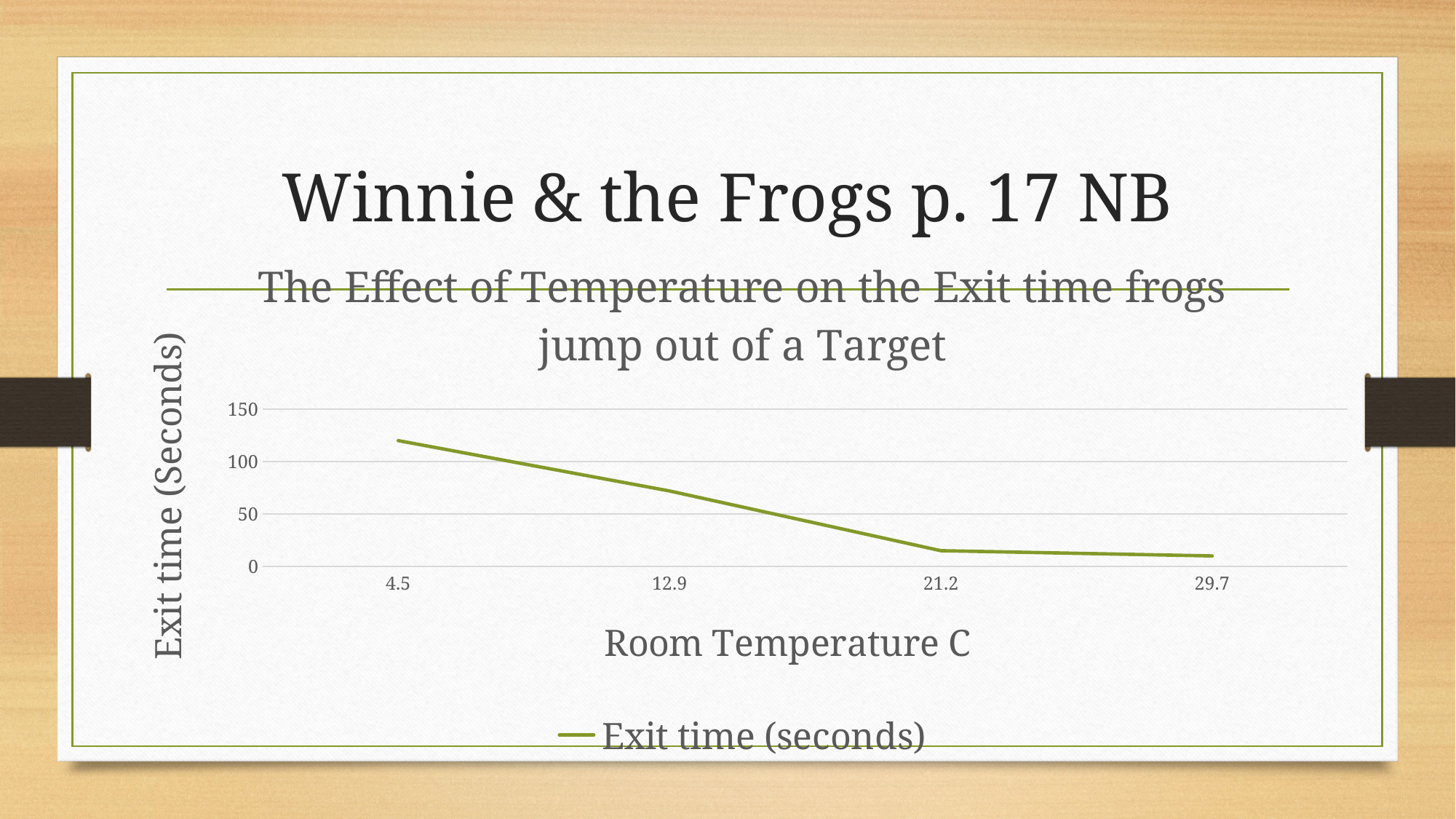
Is the exit time at 12.9 greater or less than 50? greater Is the exit time at 12.9 greater or less than 100? less Is the exit time at 4.5 greater or less than 100? greater What series name is shown in the legend? Exit time (seconds) What is the label of the y axis? Exit time (Seconds) At which room temperature is the exit time highest? 4.5 Does the exit time rise or fall as room temperature increases along the x axis? fall How many data points are plotted on the line? 4 How many series does the legend list? 1 What kind of chart is shown on the slide? line chart Which has a higher exit time, 4.5 or 21.2? 4.5